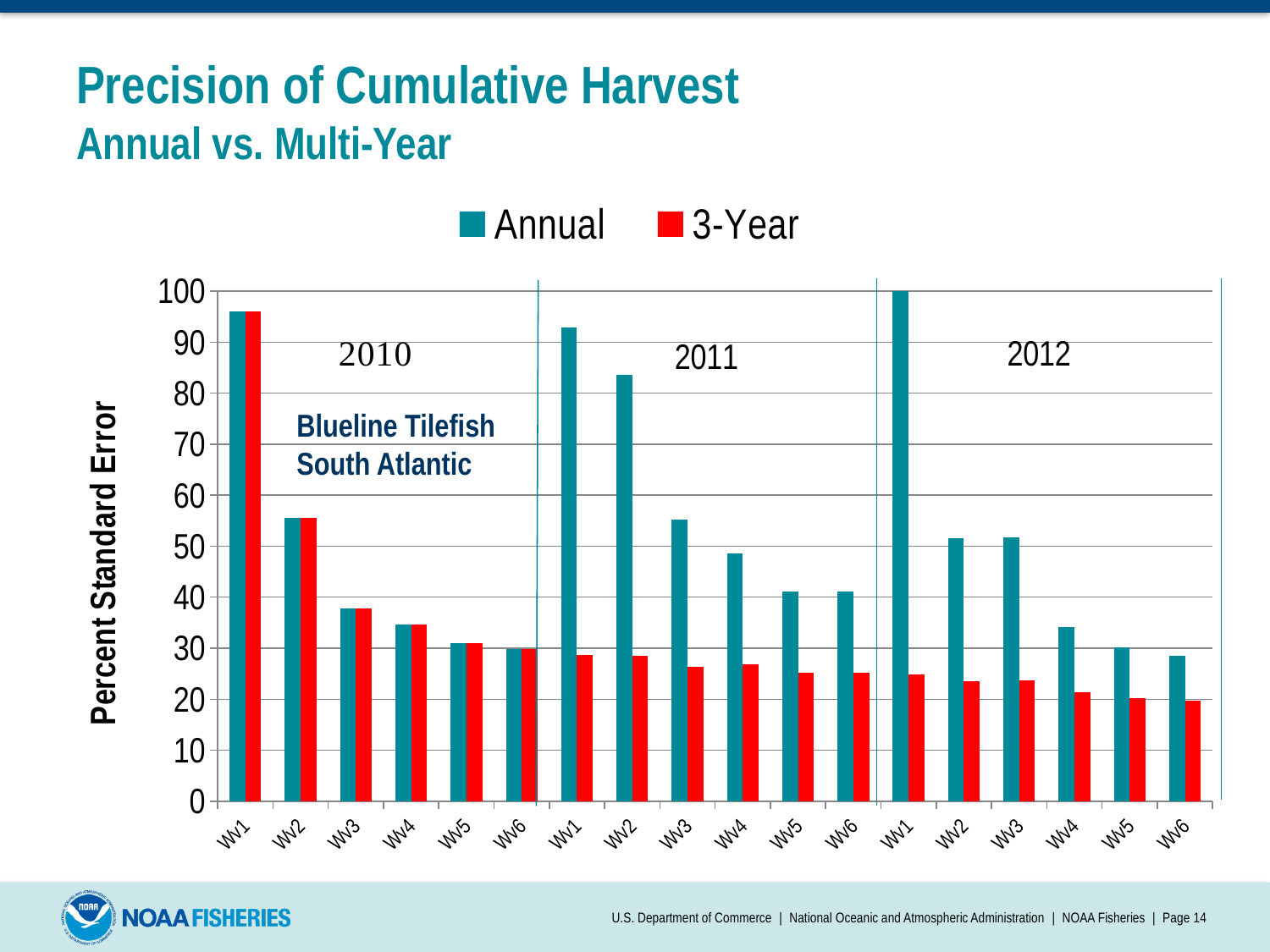
Which category has the highest Annual value? Wv1 in 2012 For Wv1 in 2011, which is larger, the Annual value or the 3-Year value? Annual Is the 3-Year value for Wv3 in 2011 greater or less than 30? less Which series is shown in red in the legend? 3-Year Is the Annual value for Wv3 in 2010 greater or less than 40? less What kind of chart is shown on the slide? bar chart How many series does the legend list? 2 Within 2010, do the Annual values rise or fall from Wv1 to Wv6? fall What is the label of the y axis? Percent Standard Error Is the Annual value for Wv2 in 2011 greater or less than 80? greater How many categories (wave bars groups) are plotted along the x axis? 18